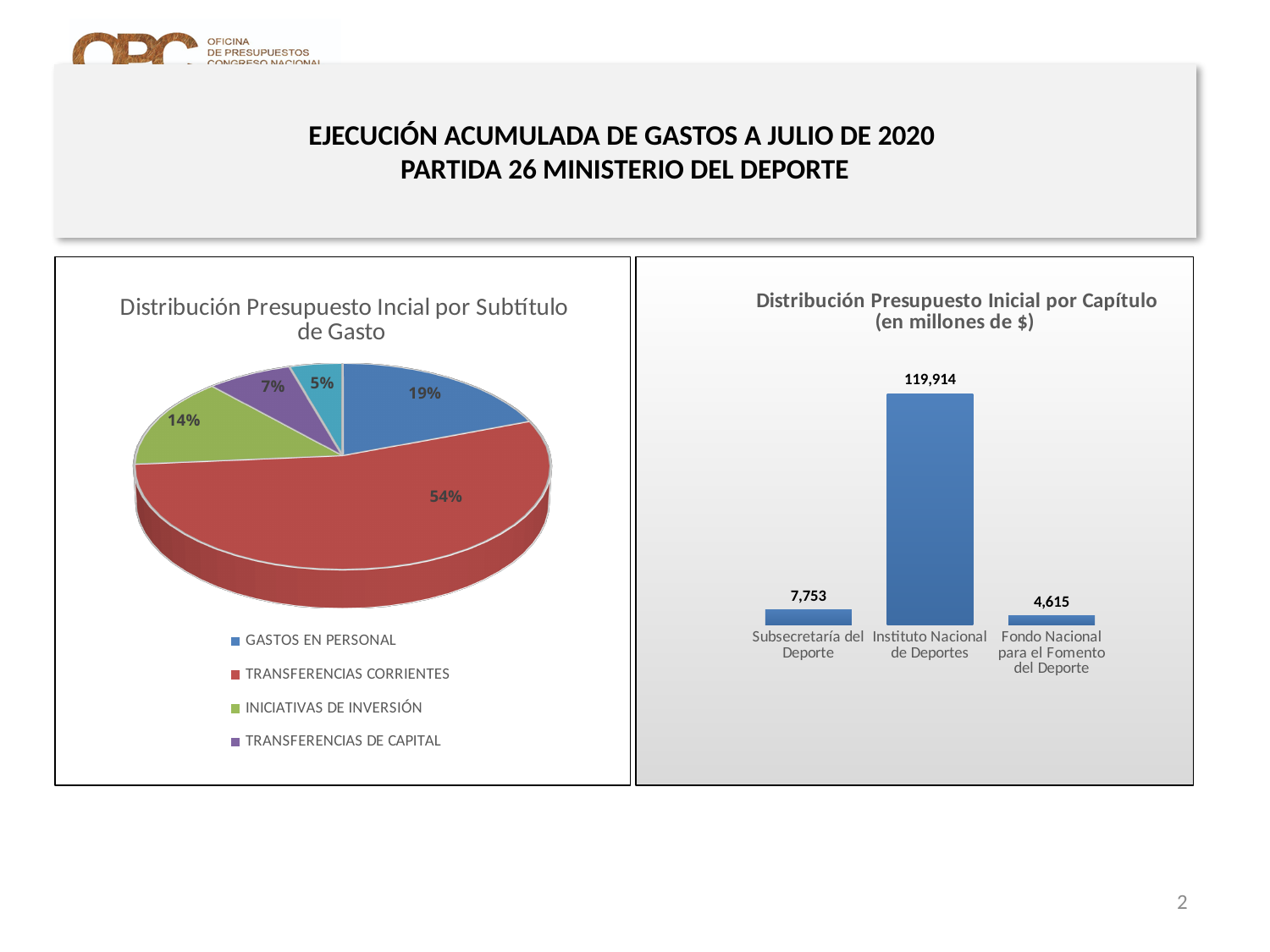
In the chart 'Distribución Presupuesto Inicial por Capítulo (en millones de $)', what is the difference between Subsecretaría del Deporte and Fondo Nacional para el Fomento del Deporte? 3,138 In the pie chart 'Distribución Presupuesto Incial por Subtítulo de Gasto', what share does GASTOS EN PERSONAL have? 19% In the pie chart 'Distribución Presupuesto Incial por Subtítulo de Gasto', what share does INICIATIVAS DE INVERSIÓN have? 14% In the pie chart 'Distribución Presupuesto Incial por Subtítulo de Gasto', how many slices are there? 5 In the pie chart 'Distribución Presupuesto Incial por Subtítulo de Gasto', what share does TRANSFERENCIAS DE CAPITAL have? 7% In the chart 'Distribución Presupuesto Inicial por Capítulo (en millones de $)', what is the value for Subsecretaría del Deporte? 7,753 What kind of chart is 'Distribución Presupuesto Inicial por Capítulo (en millones de $)'? Bar chart In the chart 'Distribución Presupuesto Inicial por Capítulo (en millones de $)', which category has the lowest value? Fondo Nacional para el Fomento del Deporte In the pie chart 'Distribución Presupuesto Incial por Subtítulo de Gasto', how many entries does the legend list? 4 In the chart 'Distribución Presupuesto Inicial por Capítulo (en millones de $)', what is the value for Instituto Nacional de Deportes? 119,914 In the pie chart 'Distribución Presupuesto Incial por Subtítulo de Gasto', which category has the largest slice? TRANSFERENCIAS CORRIENTES